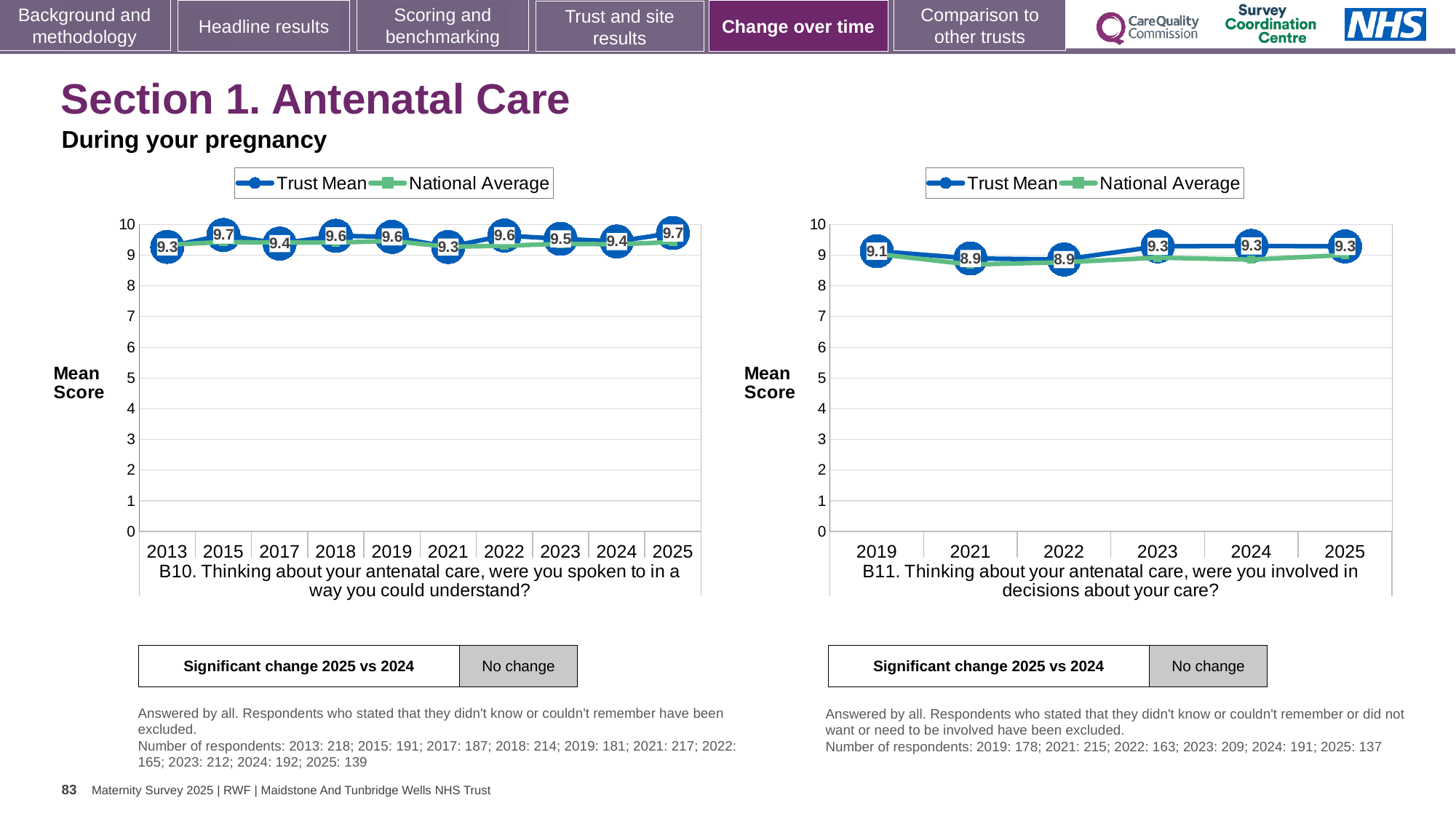
On the B10 chart (left), what is the Trust Mean for 2025? 9.7 On the B11 chart (right), what is the Trust Mean for 2022? 8.9 On the B11 chart (right), how many series does the legend list? 2 On the B11 chart (right), what is the difference between the Trust Mean in 2025 and in 2021? 0.4 On the B10 chart (left), how many years are shown on the x axis? 10 On the B11 chart (right), how many years are shown on the x axis? 6 On the B11 chart (right), is the Trust Mean for 2021 greater or less than 9? less On the B10 chart (left), what is the difference between the Trust Mean in 2015 and in 2013? 0.4 On the B10 chart (left), what is the Trust Mean for 2013? 9.3 On the B10 chart (left), which is larger, the Trust Mean for 2021 or for 2022? 2022 On the B11 chart (right), what is the Trust Mean for 2019? 9.1 What kind of chart is the B10 chart on the left? Line chart